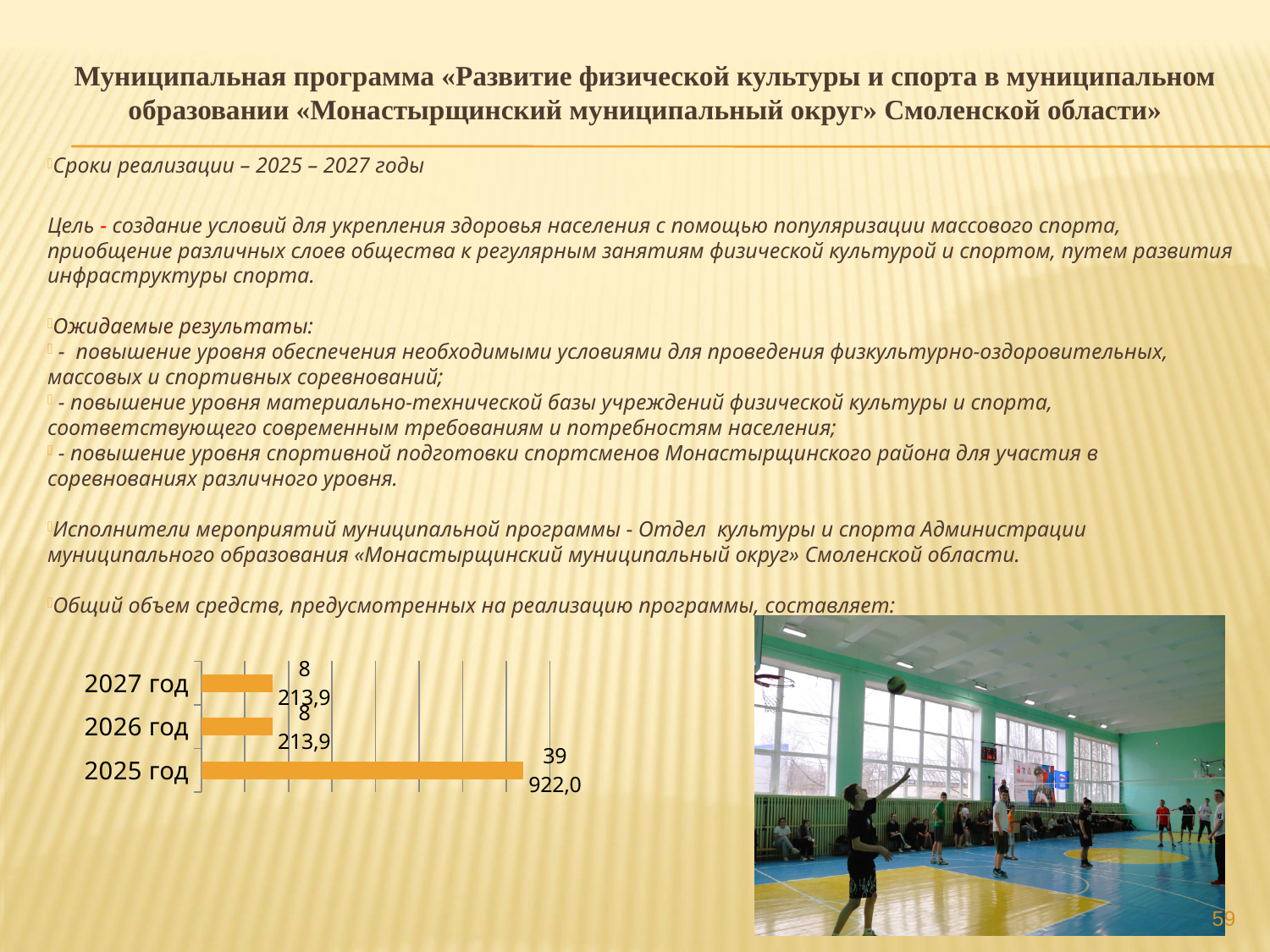
Are the bars in the chart horizontal or vertical? Horizontal What is the value shown for 2025 год in the bar chart? 39 922,0 What is the value shown for 2026 год in the bar chart? 8 213,9 Which is larger in the bar chart, the value for 2025 год or the value for 2026 год? 2025 год How many categories (years) are shown in the bar chart? 3 What is the difference between the values for 2025 год and 2027 год in the bar chart? 31 708,1 Which year has the highest value in the bar chart? 2025 год What is the value shown for 2027 год in the bar chart? 8 213,9 What kind of chart is shown on the slide? Bar chart Are the values for 2026 год and 2027 год in the bar chart the same or different? The same What colour are the bars in the chart? Orange